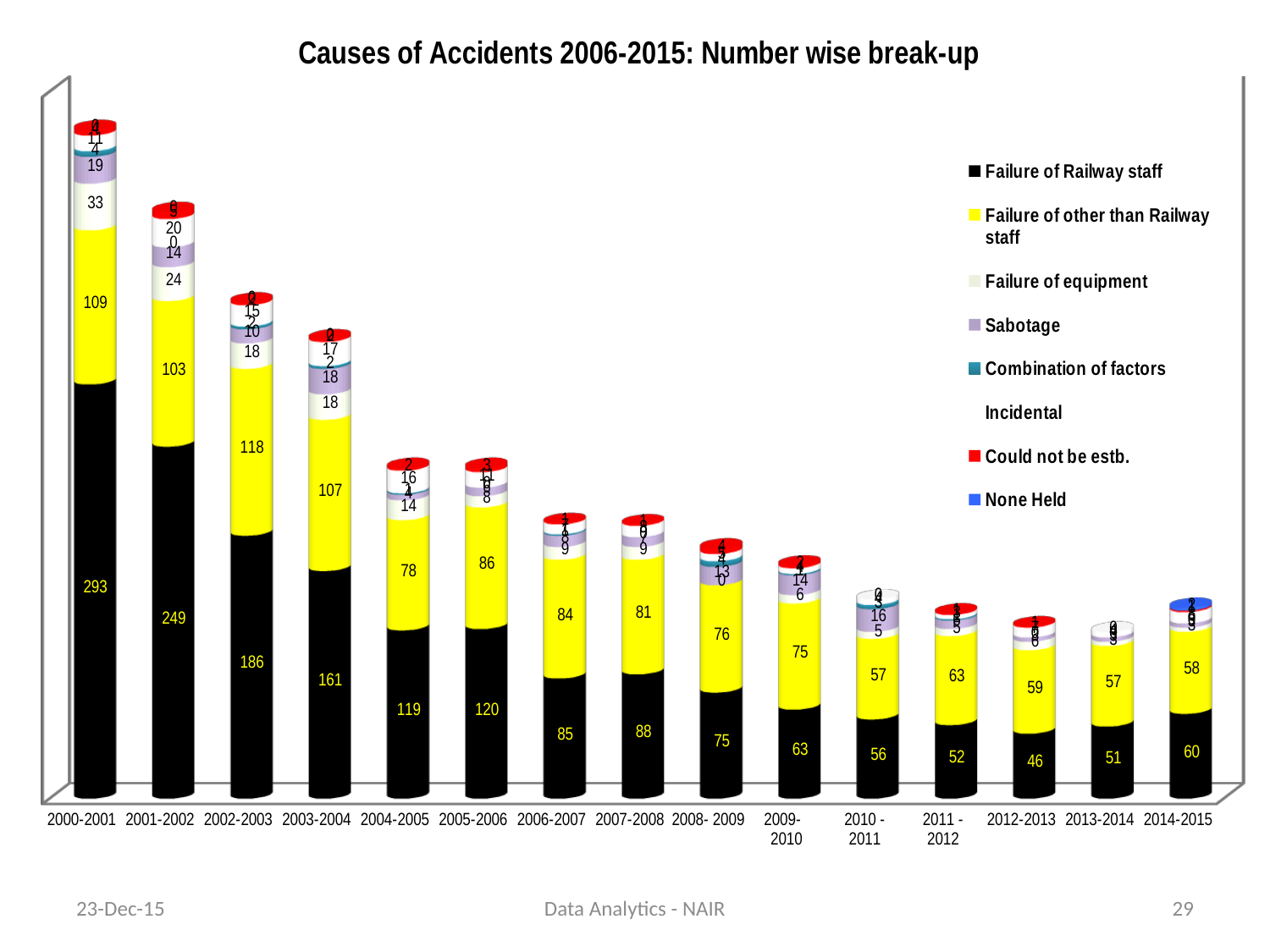
What kind of chart is shown on the slide? Stacked bar chart Which year has the larger Failure of other than Railway staff value, 2004-2005 or 2005-2006? 2005-2006 What is the difference between the Failure of Railway staff values for 2000-2001 and 2001-2002? 44 How many series does the legend list? 8 In which year is the Failure of Railway staff value highest? 2000-2001 What is the value for Failure of equipment in 2000-2001? 33 What is the value for Failure of other than Railway staff in 2002-2003? 118 Does the Failure of Railway staff value generally rise or fall from 2000-2001 to 2014-2015? Fall What is the value for Failure of Railway staff in 2000-2001? 293 What is the value for Failure of Railway staff in 2014-2015? 60 How many year categories are shown along the x axis? 15 In which year is the Failure of Railway staff value lowest? 2012-2013